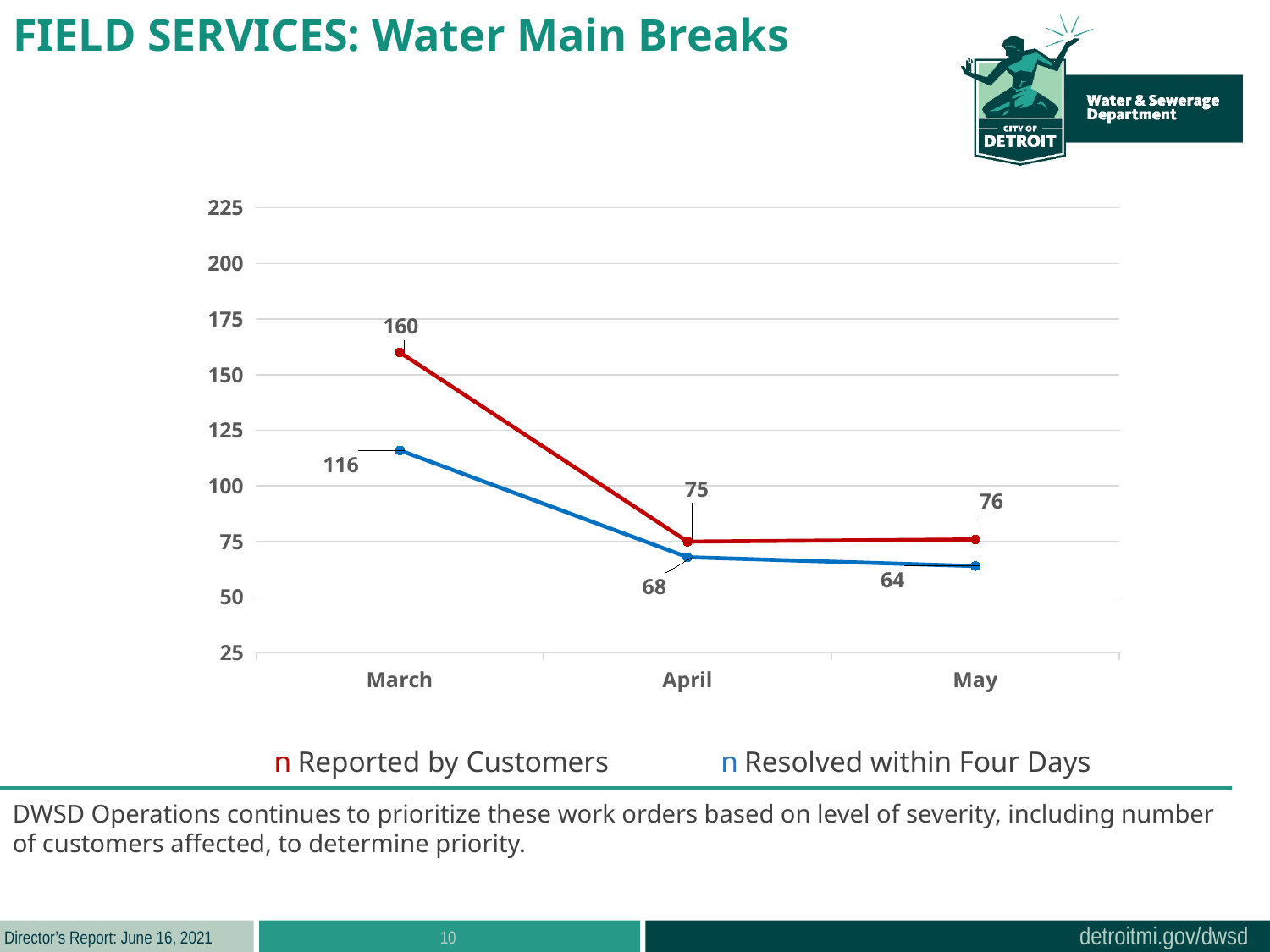
Does the Reported by Customers series rise or fall from March to April? fall Which is larger in April: Reported by Customers or Resolved within Four Days? Reported by Customers What is the difference between Reported by Customers and Resolved within Four Days in March? 44 What colour is the line for Resolved within Four Days? blue What is the value for Resolved within Four Days in April? 68 In which month is the Resolved within Four Days value lowest? May How many series does the legend list? 2 How many months are plotted on the x axis? 3 What kind of chart is shown on the slide? line chart What is the value for Reported by Customers in March? 160 In which month is the Reported by Customers value highest? March What is the value for Reported by Customers in May? 76